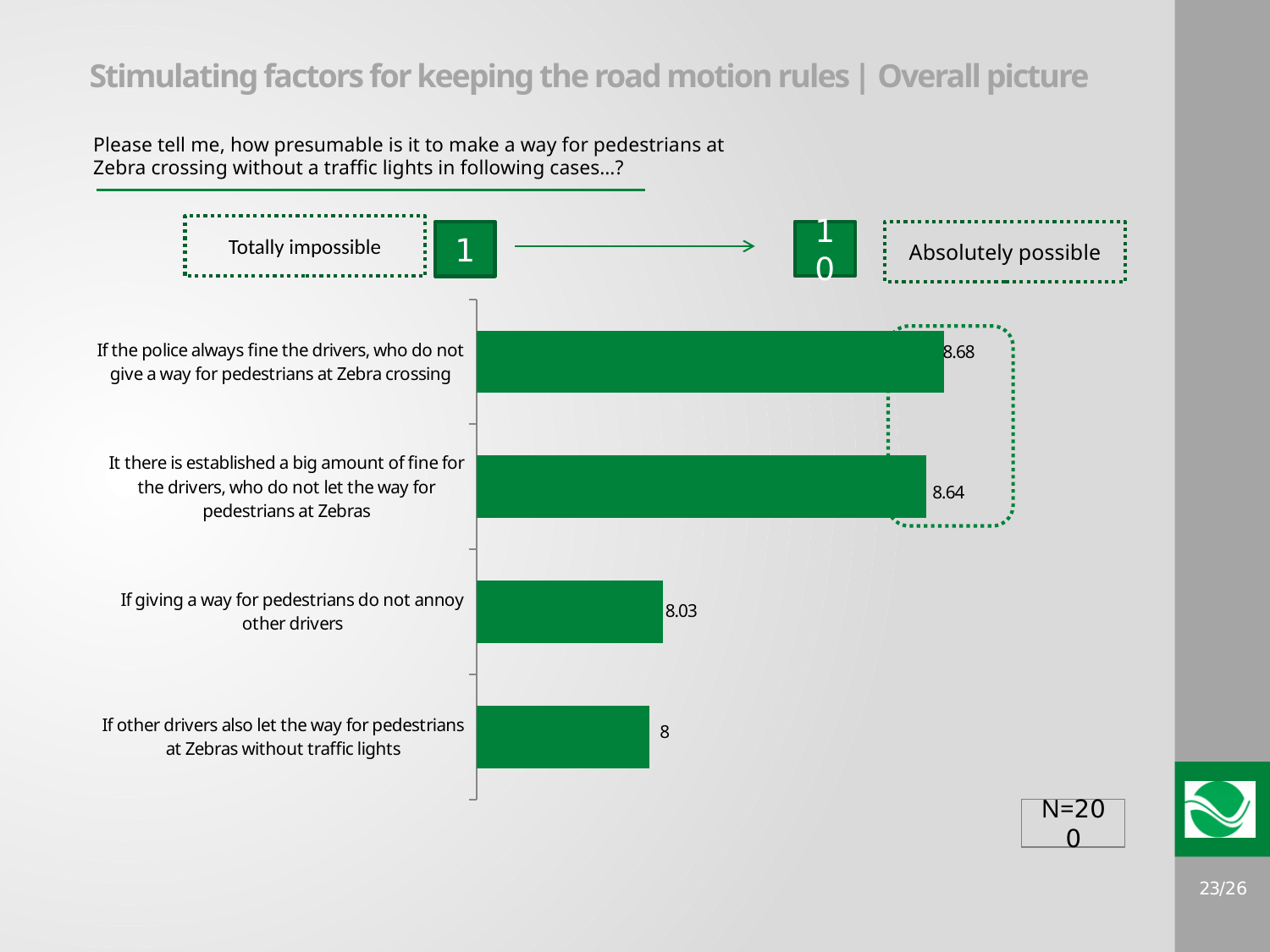
How many categories are shown in the chart? 4 What is the difference between the value for 'If the police always fine the drivers...' and the value for 'If other drivers also let the way for pedestrians...'? 0.68 Which is larger: the value for 'If giving a way for pedestrians do not annoy other drivers' or the value for 'If other drivers also let the way for pedestrians at Zebras without traffic lights'? If giving a way for pedestrians do not annoy other drivers What is the value for 'It there is established a big amount of fine for the drivers, who do not let the way for pedestrians at Zebras'? 8.64 What is the value for 'If giving a way for pedestrians do not annoy other drivers'? 8.03 Which category has the highest value? If the police always fine the drivers, who do not give a way for pedestrians at Zebra crossing What is the sample size (N) shown on the slide? N=200 What is the difference between the value for 'It there is established a big amount of fine...' and the value for 'If giving a way for pedestrians do not annoy other drivers'? 0.61 Which category has the lowest value? If other drivers also let the way for pedestrians at Zebras without traffic lights What is the value for 'If the police always fine the drivers, who do not give a way for pedestrians at Zebra crossing'? 8.68 What kind of chart is shown on the slide? Bar chart What is the value for 'If other drivers also let the way for pedestrians at Zebras without traffic lights'? 8